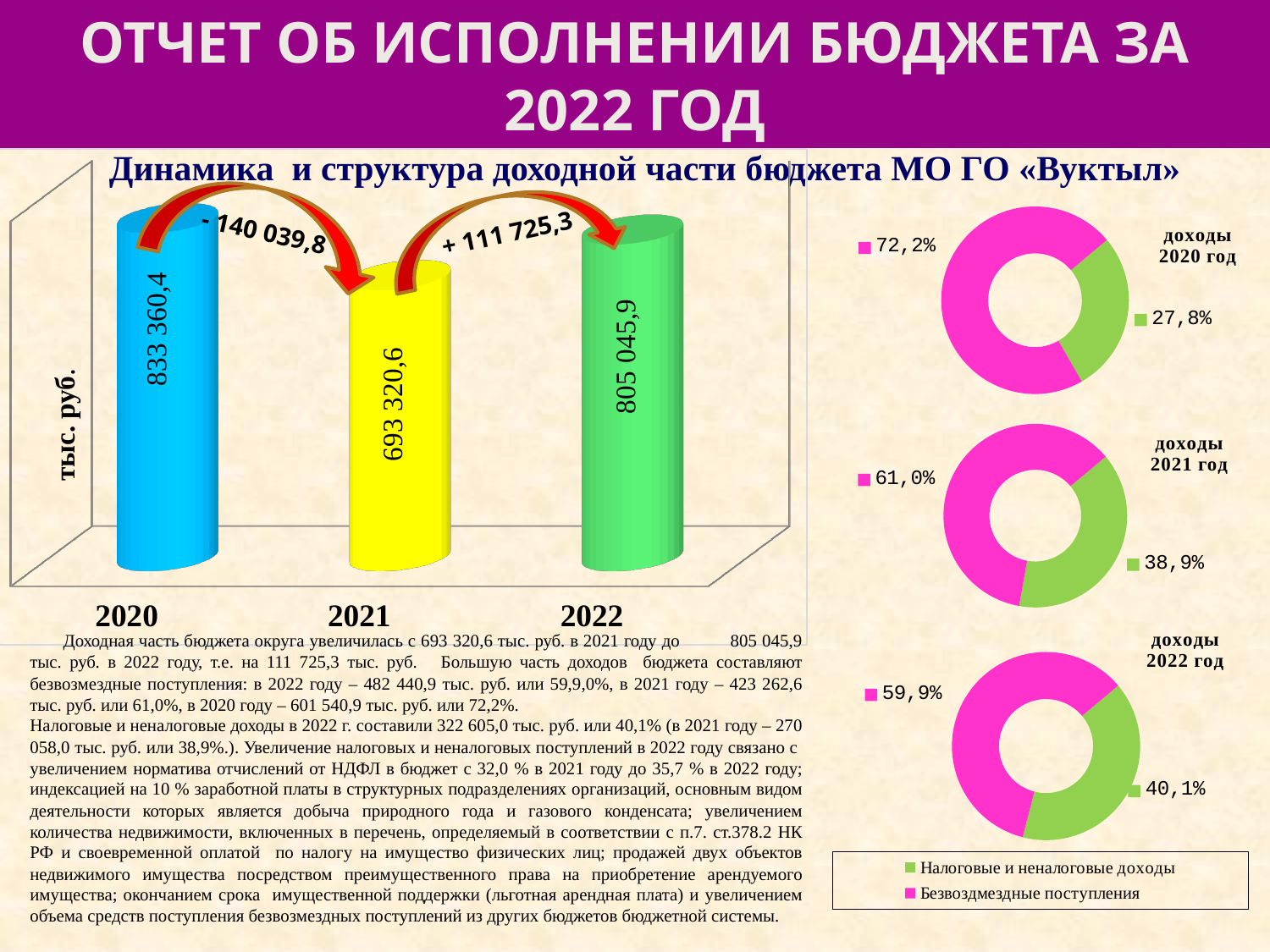
What type of chart is used on the left side of the slide to show the budget revenue by year? Bar chart In the bar chart on the left, which year has the highest value? 2020 In the donut chart titled 'доходы 2021 год', which is larger: Налоговые и неналоговые доходы or Безвоздмездные поступления? Безвоздмездные поступления In the bar chart on the left, what is the difference between the 2022 value and the 2021 value? 111 725,3 In the bar chart on the left, what is the value for 2021? 693 320,6 In the bar chart on the left, what is the value for 2022? 805 045,9 In the bar chart on the left, what is the value for 2020? 833 360,4 In the bar chart on the left, what is the difference between the 2020 value and the 2021 value? 140 039,8 In the bar chart on the left, which year has the lowest value? 2021 In the bar chart on the left, how many years are shown? 3 In the donut chart titled 'доходы 2020 год', what share is shown for Безвоздмездные поступления? 72,2% In the donut chart titled 'доходы 2022 год', what share is shown for Налоговые и неналоговые доходы? 40,1%